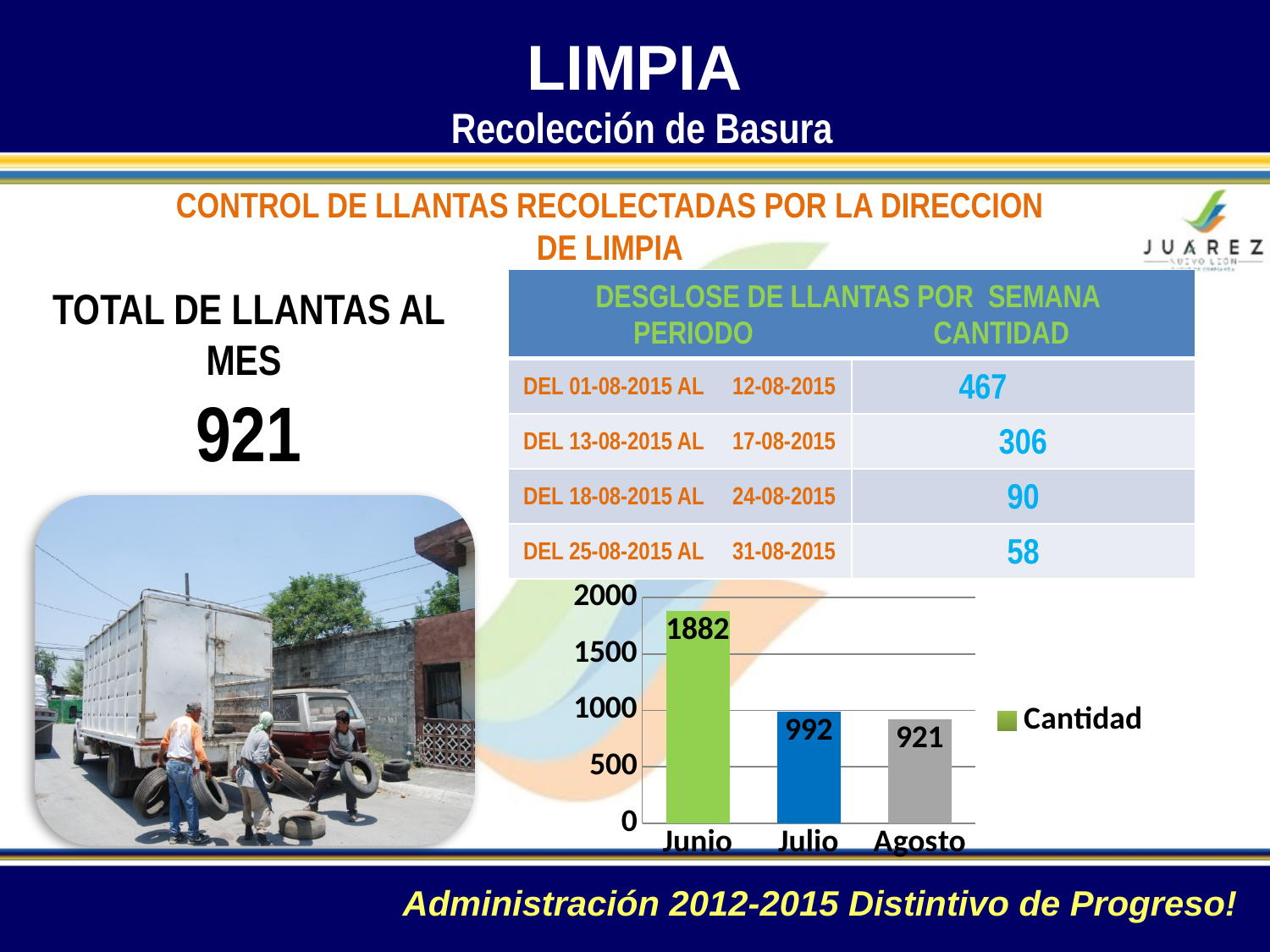
How many months are shown in the bar chart? 3 What is the value for Julio in the bar chart? 992 What is the difference between the values for Junio and Julio in the bar chart? 890 Which month has the highest value in the bar chart? Junio What kind of chart is shown on the slide? bar chart What is the difference between the values for Julio and Agosto in the bar chart? 71 What series name does the legend of the bar chart show? Cantidad Is the value for Julio in the bar chart greater or less than 1000? less What is the value for Junio in the bar chart? 1882 What is the value for Agosto in the bar chart? 921 Which is larger in the bar chart, the value for Junio or the value for Agosto? Junio Which month has the lowest value in the bar chart? Agosto